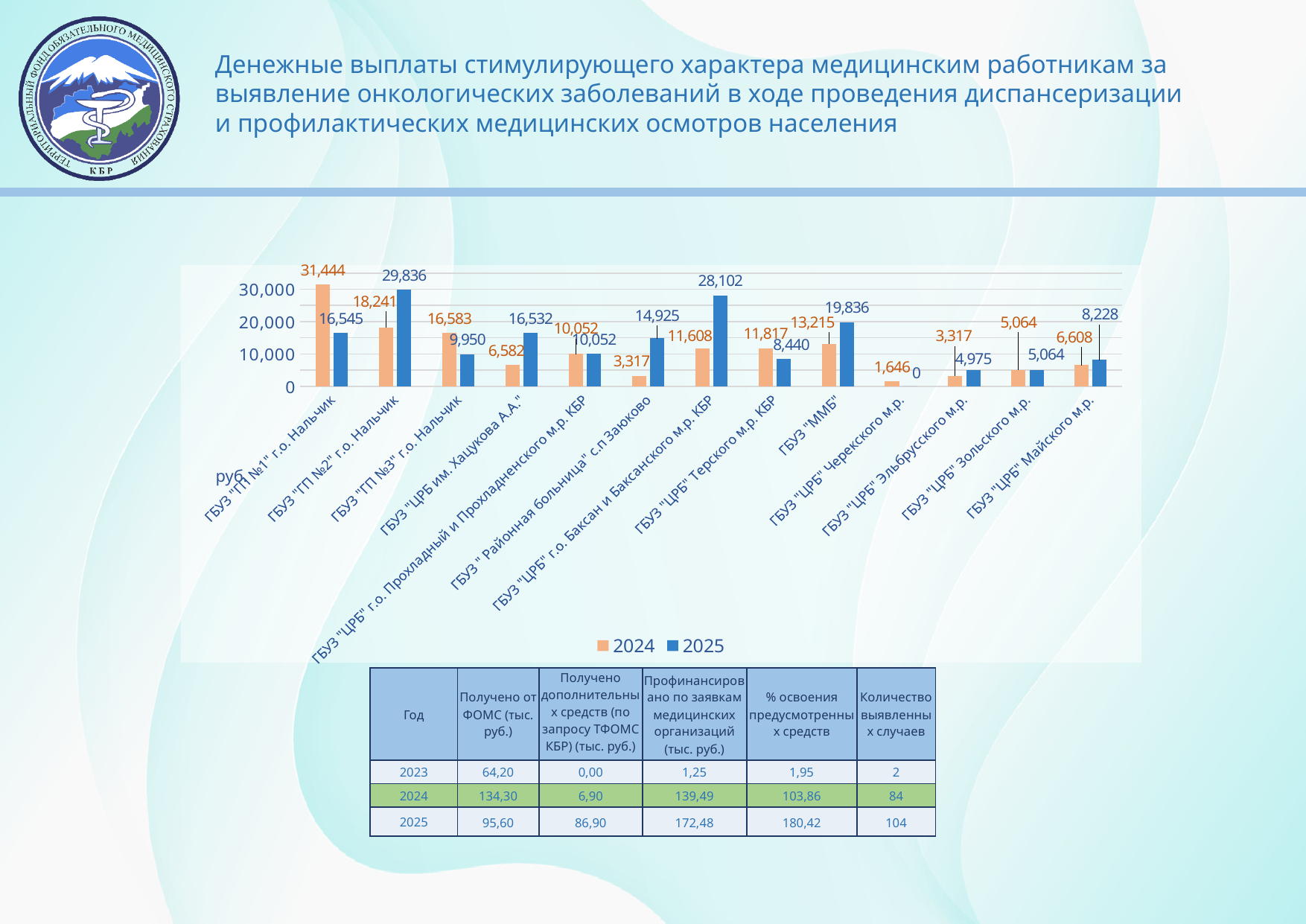
What is the 2025 value for ГБУЗ "ММБ"? 19,836 Which organisation has the highest 2025 value? ГБУЗ "ГП №2" г.о. Нальчик What are the two series listed in the chart legend? 2024 and 2025 What type of chart is shown on the slide? bar chart What is the difference between the 2024 and 2025 values for ГБУЗ "ГП №1" г.о. Нальчик? 14,899 Which organisation has the highest 2024 value? ГБУЗ "ГП №1" г.о. Нальчик What is the 2024 value for ГБУЗ "ГП №1" г.о. Нальчик? 31,444 Which organisation has the lowest 2025 value? ГБУЗ "ЦРБ" Черекского м.р. How many organisations (categories) are shown on the x axis of the chart? 13 Which is larger for ГБУЗ "ЦРБ им. Хацукова А.А.": the 2024 value or the 2025 value? 2025 How many series does the chart legend list? 2 What is the 2025 value for ГБУЗ "ЦРБ" г.о. Баксан и Баксанского м.р. КБР? 28,102